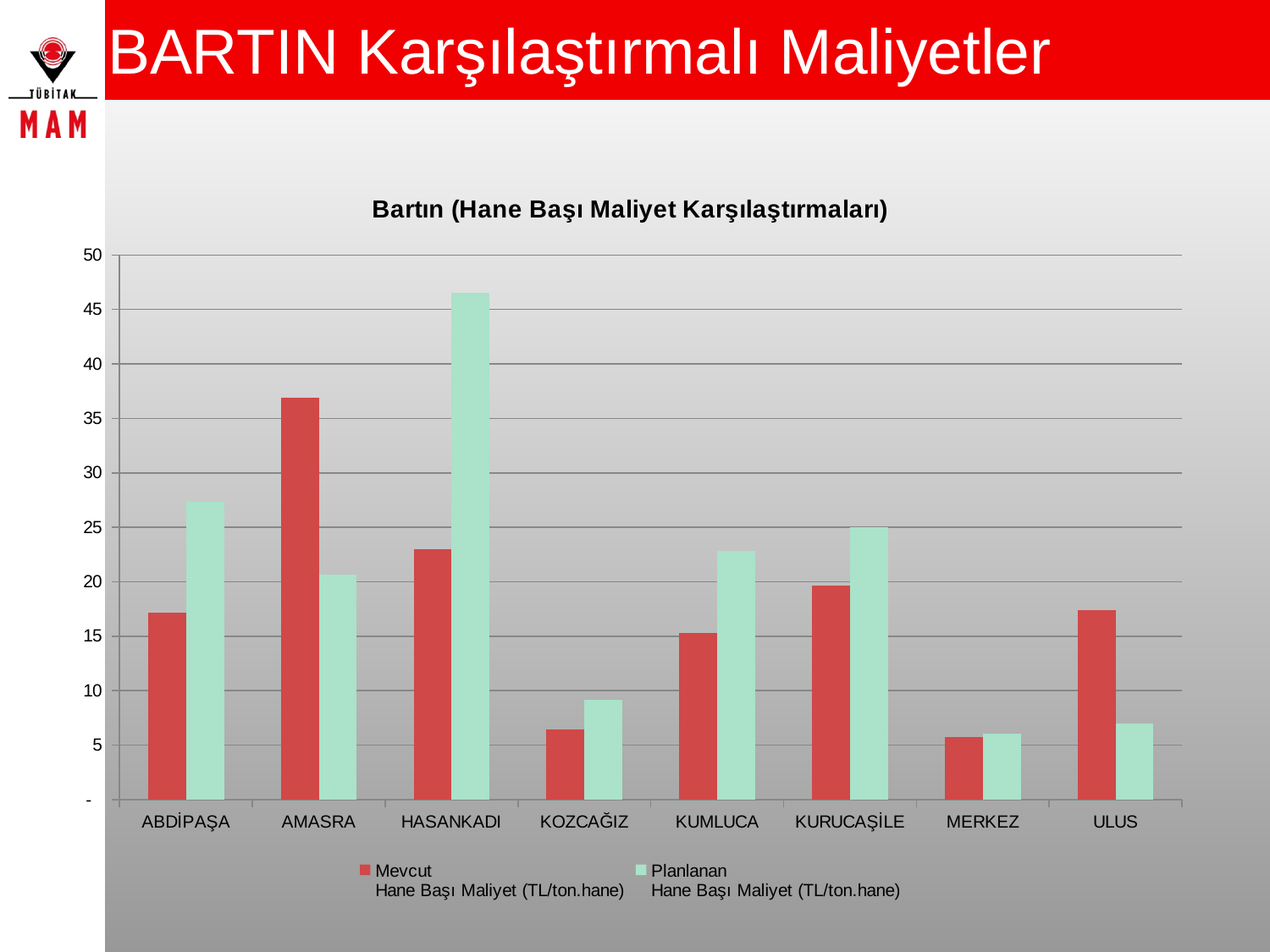
For HASANKADI, which is larger: the Mevcut or the Planlanan value? Planlanan Which district has the highest Mevcut Hane Başı Maliyet value? AMASRA For ULUS, which is larger: the Mevcut or the Planlanan value? Mevcut Is the Mevcut value for AMASRA greater or less than 35? greater Which district has the highest Planlanan Hane Başı Maliyet value? HASANKADI What is the title of the chart? Bartın (Hane Başı Maliyet Karşılaştırmaları) How many series does the chart legend list? 2 Is the Mevcut value for MERKEZ greater or less than 10? less How many districts are shown on the x axis of the chart? 8 For AMASRA, which is larger: the Mevcut or the Planlanan value? Mevcut What kind of chart is shown on the slide? bar chart Is the Planlanan value for HASANKADI greater or less than 45? greater